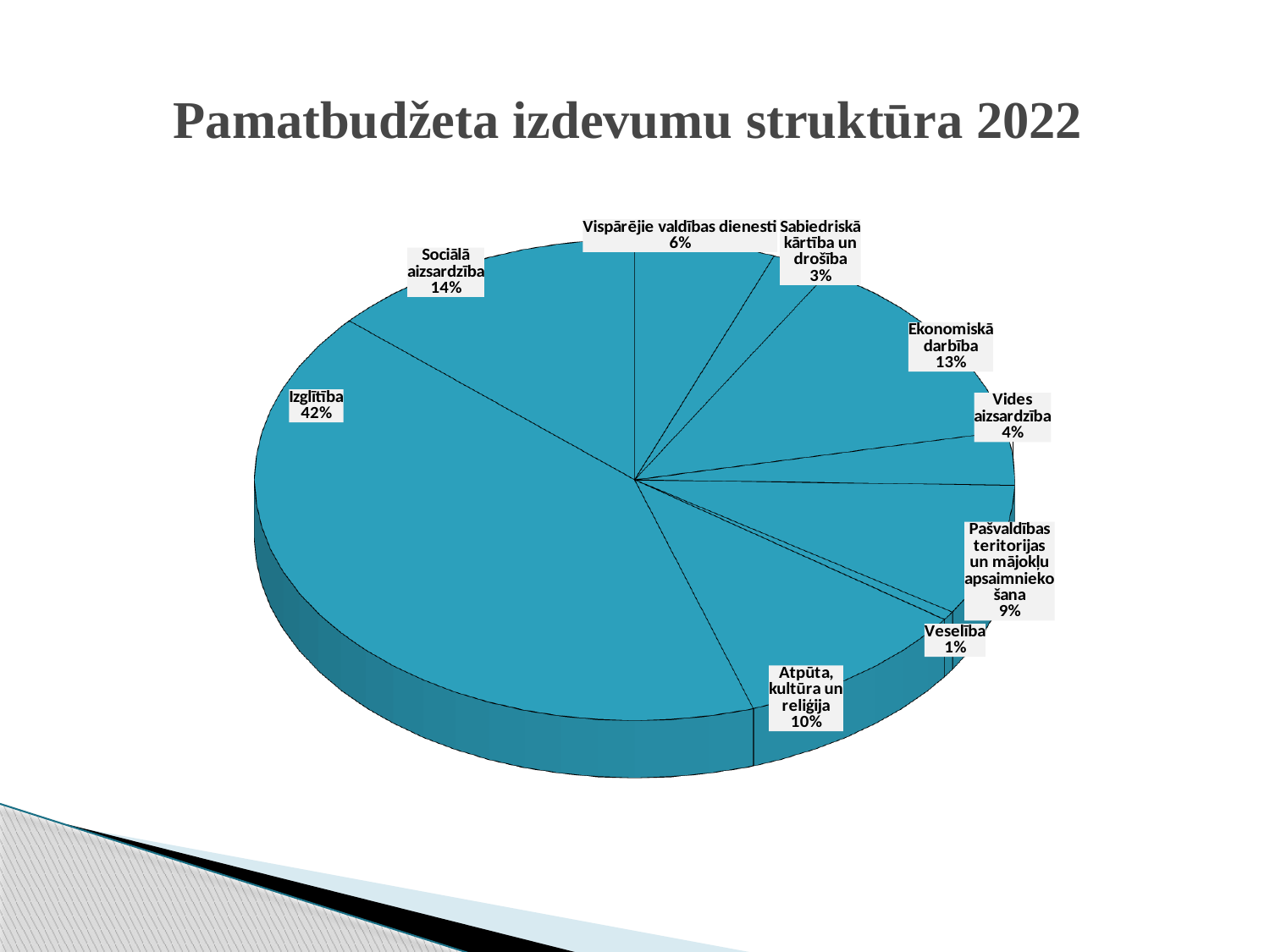
What share of the pie does Veselība have? 1% Which category has the largest share of the pie? Izglītība What share of the pie does Atpūta, kultūra un reliģija have? 10% What is the difference between the shares of Izglītība and Sociālā aizsardzība? 28% What share of the pie does Sociālā aizsardzība have? 14% What share of the pie does Ekonomiskā darbība have? 13% Which is larger, the share of Vides aizsardzība or the share of Sabiedriskā kārtība un drošība? Vides aizsardzība What kind of chart is shown on the slide? pie chart How many categories are shown in the pie chart? 9 What share of the pie does Izglītība have? 42% Which category has the smallest share of the pie? Veselība What is the title of the chart? Pamatbudžeta izdevumu struktūra 2022